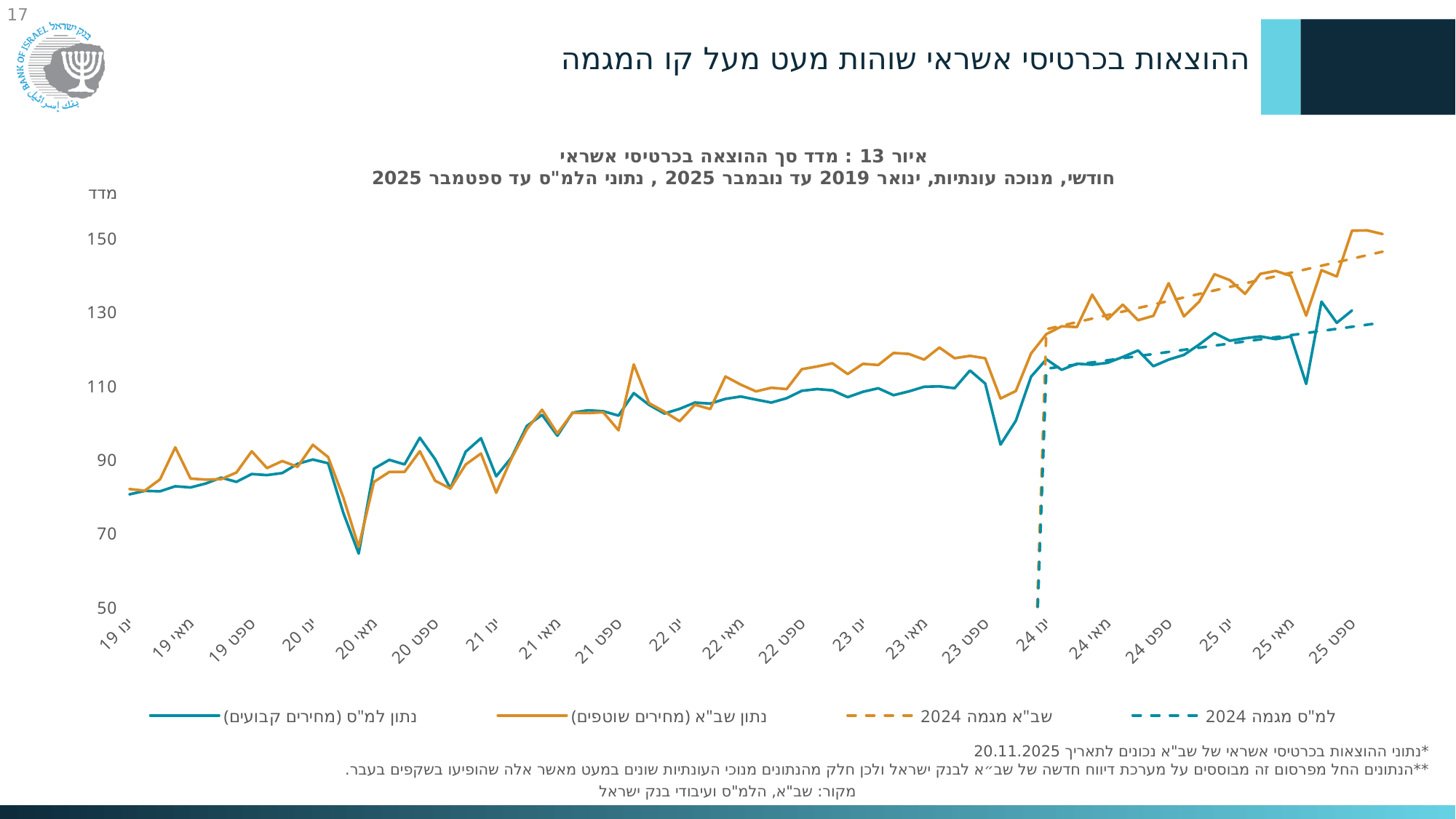
What kind of chart is shown on the slide? line chart Near which x-axis label do both solid lines reach their lowest point? מאי 20 How many labels are shown on the x axis? 21 Is the value of the orange line (נתון שב"א) at ספט 25 greater or less than 130? greater Is the value of the orange line (נתון שב"א) at ינו 19 greater or less than 90? less At ספט 25, which line is higher: נתון שב"א (orange) or נתון למ"ס (blue)? נתון שב"א (orange) How many series does the legend list? 4 Overall, do the solid lines rise or fall from ינו 19 to ספט 25? rise What label is shown on the y axis? מדד What is the figure number given in the chart title? איור 13 Is the lowest value of the blue line (נתון למ"ס), near מאי 20, greater or less than 70? less